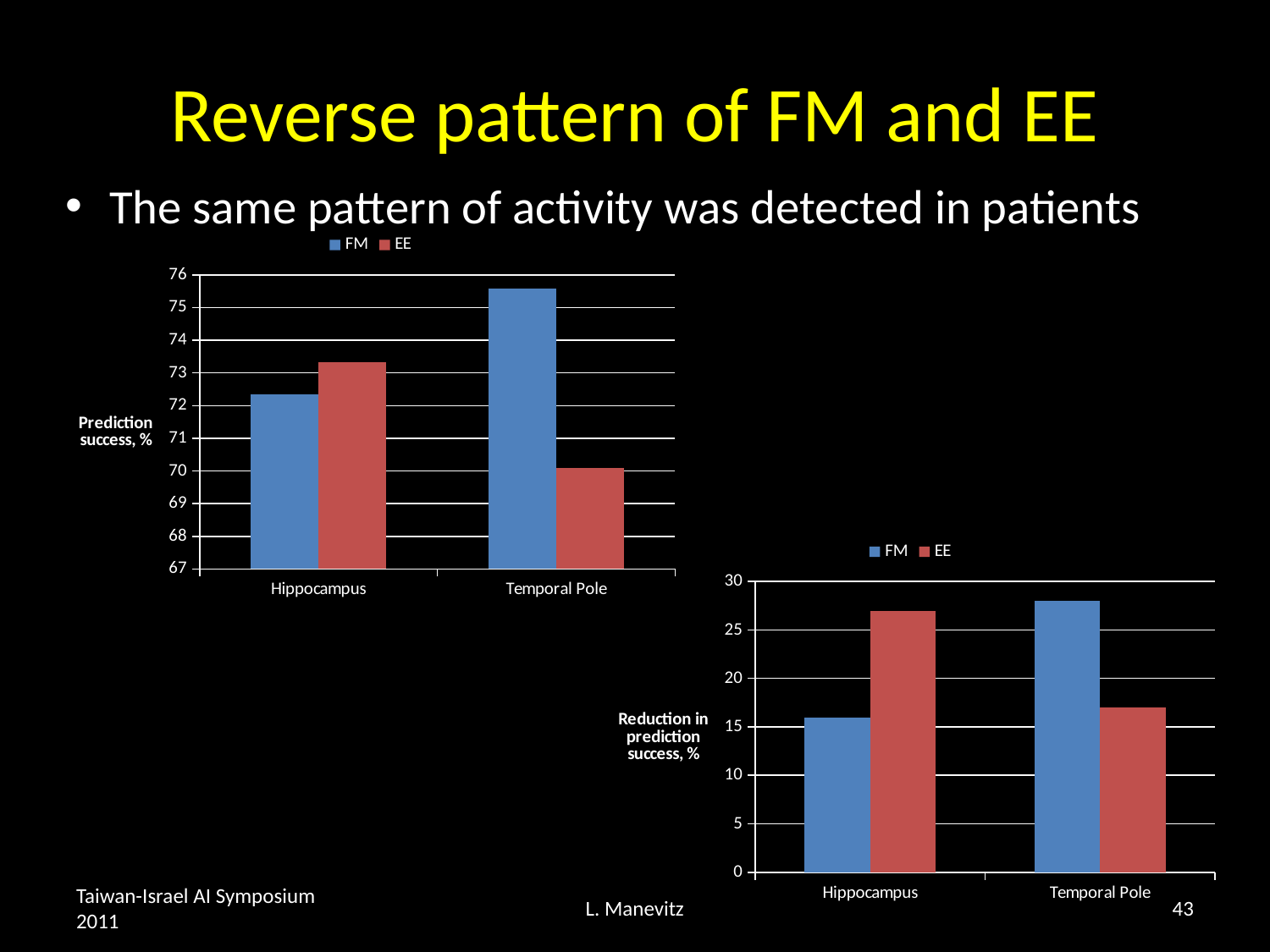
In the lower-right chart (Reduction in prediction success, %), is the FM value for Hippocampus greater or less than 20? less In the upper-left chart (Prediction success, %), is the FM value for Temporal Pole greater or less than 75? greater What type of chart is the upper-left chart labelled "Prediction success, %"? bar chart In the lower-right chart (Reduction in prediction success, %), which series has the larger value for Temporal Pole, FM or EE? FM How many series does the legend of the upper-left chart (Prediction success, %) list? 2 In the lower-right chart (Reduction in prediction success, %), is the EE value for Hippocampus greater or less than 25? greater How many categories are shown on the x axis of the lower-right chart (Reduction in prediction success, %)? 2 What colour are the EE bars in both charts? red In the upper-left chart (Prediction success, %), which series has the larger value for Temporal Pole, FM or EE? FM In the upper-left chart (Prediction success, %), which series has the larger value for Hippocampus, FM or EE? EE